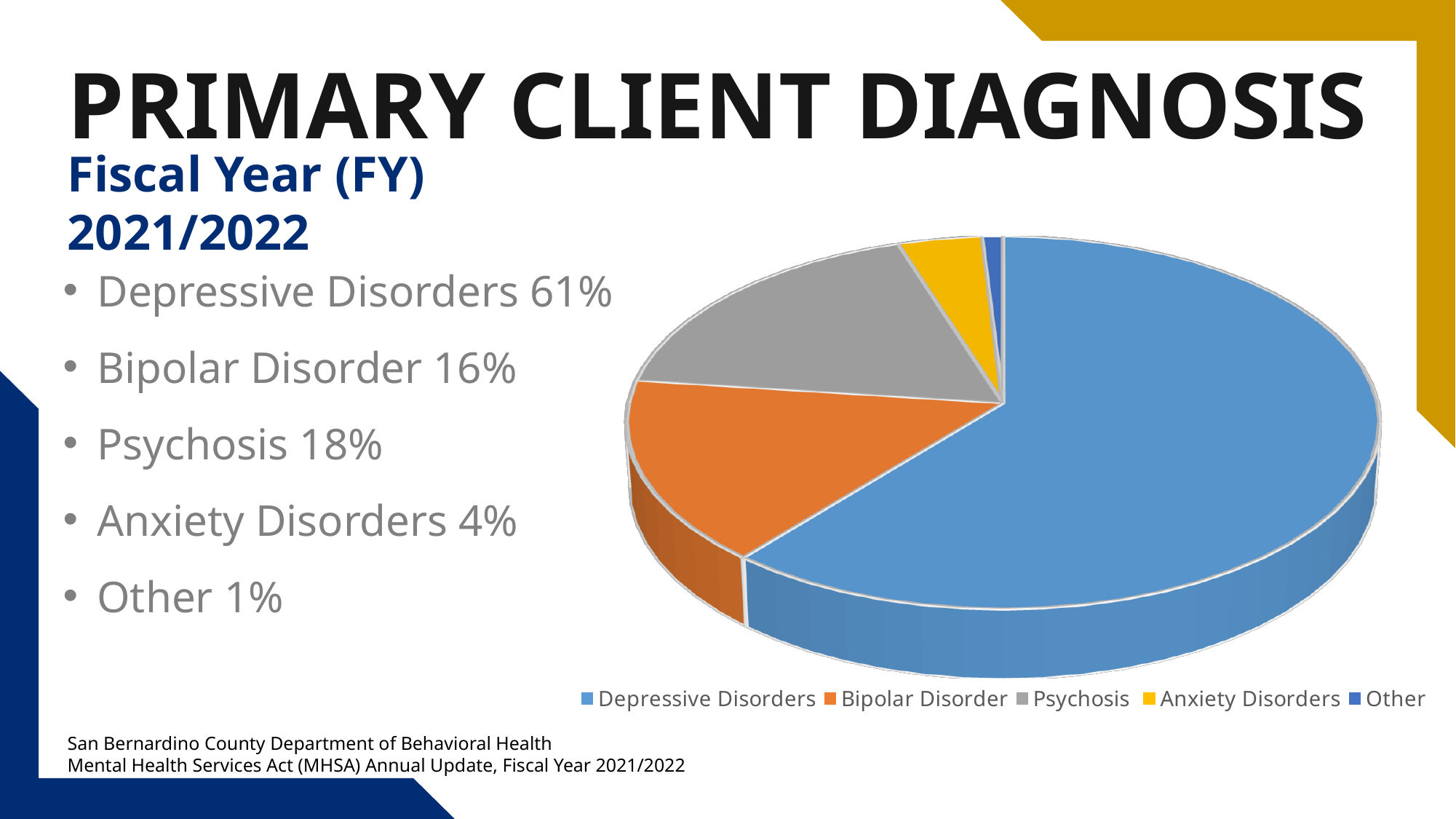
What percentage is shown for Anxiety Disorders? 4% What percentage is shown for Psychosis? 18% What is the difference in percentage points between Depressive Disorders and Psychosis? 43 What share of clients have Depressive Disorders as their primary diagnosis? 61% How many categories does the pie chart show? 5 Which diagnosis category has the smallest share of the pie? Other Which fiscal year does the chart cover? 2021/2022 Which diagnosis category has the largest share of the pie? Depressive Disorders What colour represents Bipolar Disorder in the pie chart? orange Which is larger, the share for Psychosis or the share for Bipolar Disorder? Psychosis What kind of chart is shown on the slide? pie chart What percentage is shown for Bipolar Disorder? 16%